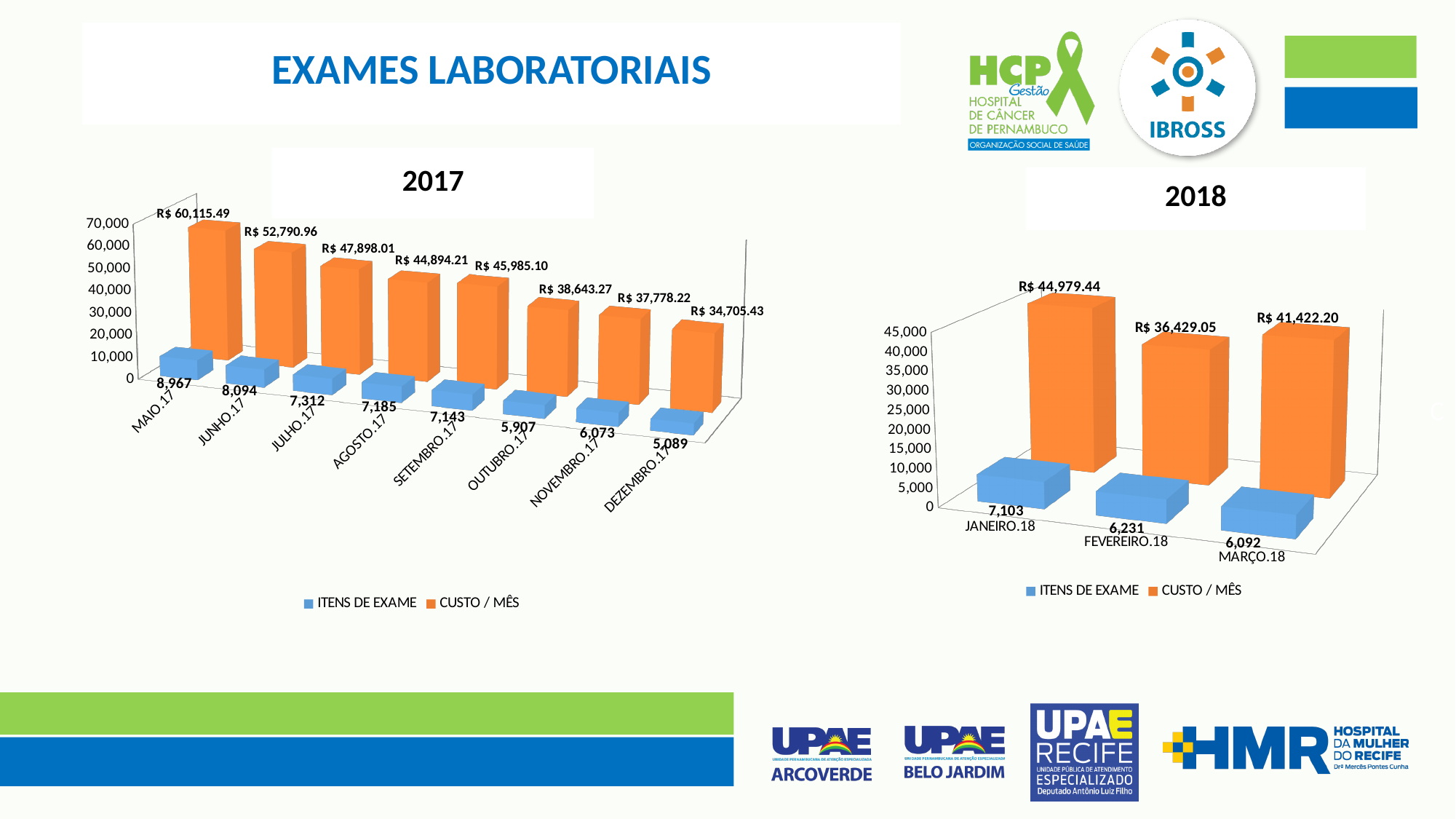
In the 2017 chart, how many ITENS DE EXAME are shown for OUTUBRO.17? 5,907 In the 2018 chart, what is the difference in ITENS DE EXAME between JANEIRO.18 and MARÇO.18? 1,011 What type of chart is the 2018 chart? Bar chart In the 2017 chart, which month has the lowest ITENS DE EXAME value? DEZEMBRO.17 How many series does the legend of the 2018 chart list? 2 In the 2017 chart, what is the difference in ITENS DE EXAME between MAIO.17 and JUNHO.17? 873 In the 2018 chart, what is the CUSTO / MÊS value for FEVEREIRO.18? R$ 36,429.05 In the 2017 chart, does the CUSTO / MÊS generally rise or fall from MAIO.17 to DEZEMBRO.17? Fall How many months are shown in the 2017 chart? 8 In the 2017 chart, which is larger, the CUSTO / MÊS for AGOSTO.17 or for SETEMBRO.17? SETEMBRO.17 In the 2018 chart, which month has the highest CUSTO / MÊS? JANEIRO.18 In the 2017 chart, what is the CUSTO / MÊS value for MAIO.17? R$ 60,115.49